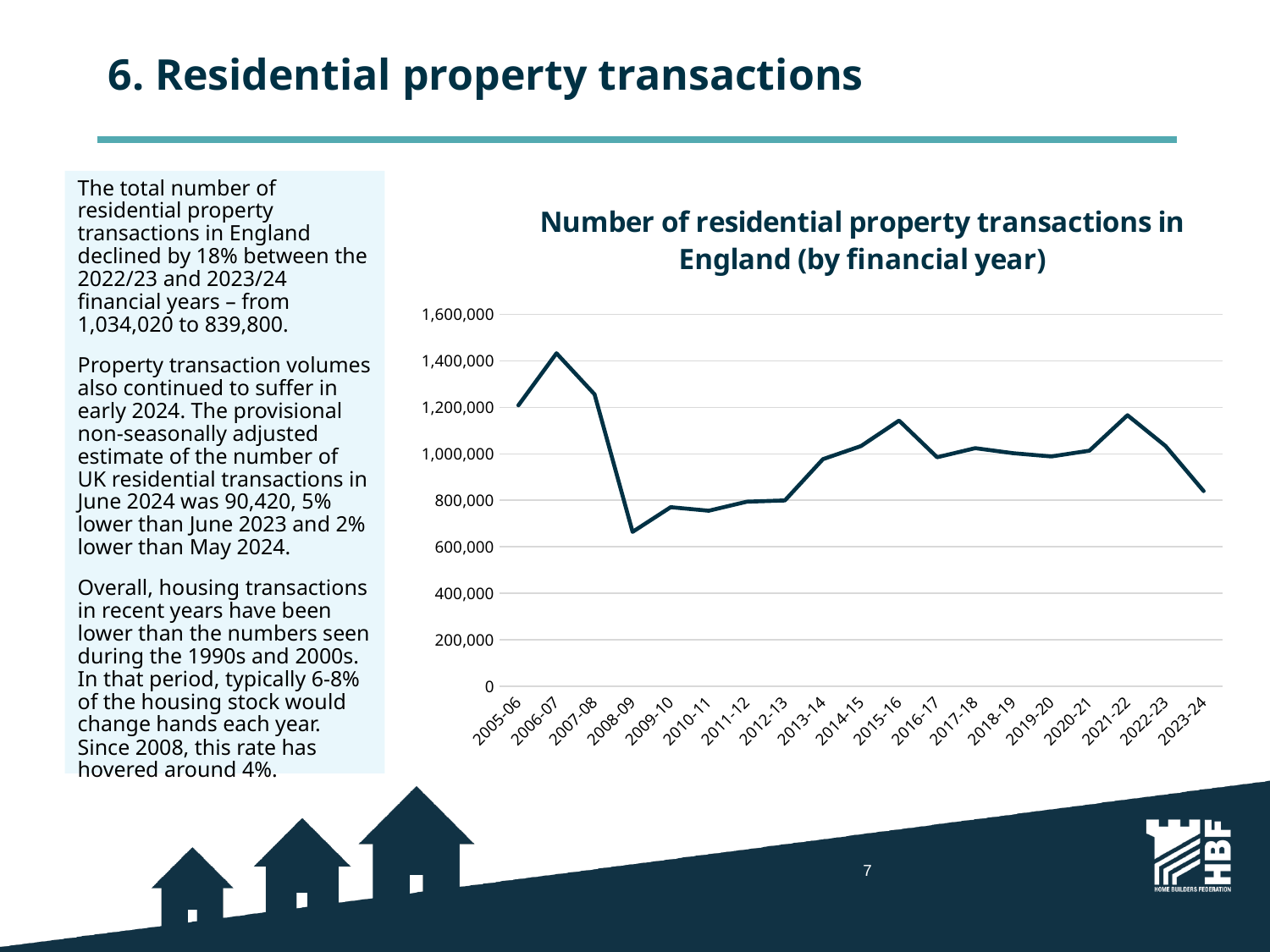
Which financial year has the lowest number of residential property transactions? 2008-09 What is the number of residential property transactions in England for 2023-24? 839,800 What is the title of the chart? Number of residential property transactions in England (by financial year) Is the value for 2009-10 greater or less than 800,000? less Which is larger, the value for 2006-07 or the value for 2021-22? 2006-07 Which financial year has the highest number of residential property transactions? 2006-07 Is the value for 2006-07 greater or less than 1,400,000? greater Is the value for 2008-09 greater or less than 800,000? less Do the values rise or fall from 2021-22 to 2023-24? fall What kind of chart is shown on the slide? line chart How many financial years are plotted on the x axis of the chart? 19